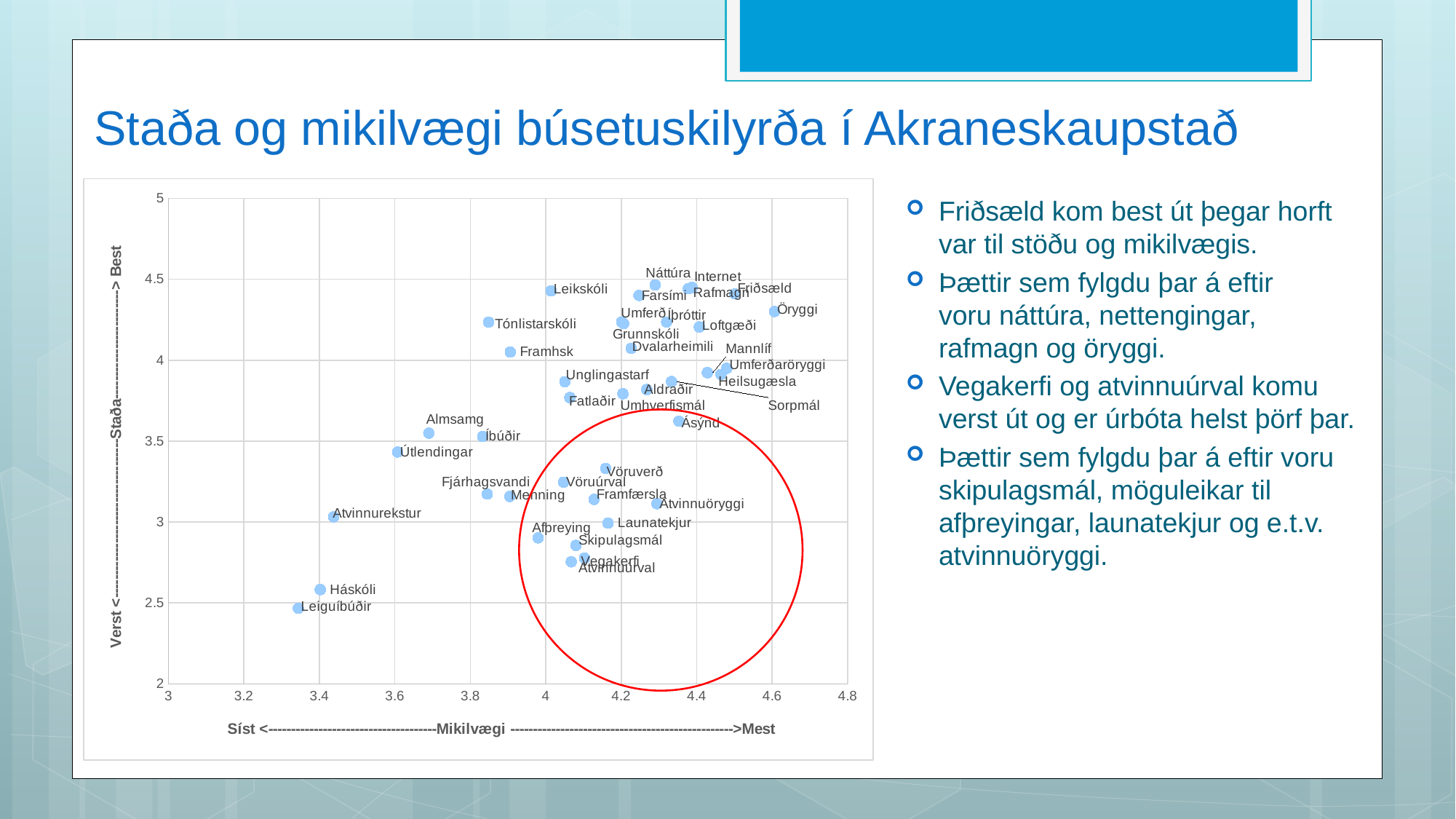
Which point has the lowest value on the vertical (Staða) axis? Leiguíbúðir What kind of chart is shown on the slide? Scatter chart Is the Staða (vertical) value for Leikskóli greater or less than 4? greater Which point has the highest value on the horizontal (Mikilvægi) axis? Öryggi Is the Staða (vertical) value for Vegakerfi greater or less than 3? less What is the label of the horizontal axis of the chart? Síst <---Mikilvægi--->Mest Is the Staða (vertical) value for Háskóli greater or less than 3? less Which point has a higher Staða (vertical) value, Leikskóli or Háskóli? Leikskóli Which point has a higher Mikilvægi (horizontal) value, Öryggi or Útlendingar? Öryggi Which point has the lowest value on the horizontal (Mikilvægi) axis? Leiguíbúðir